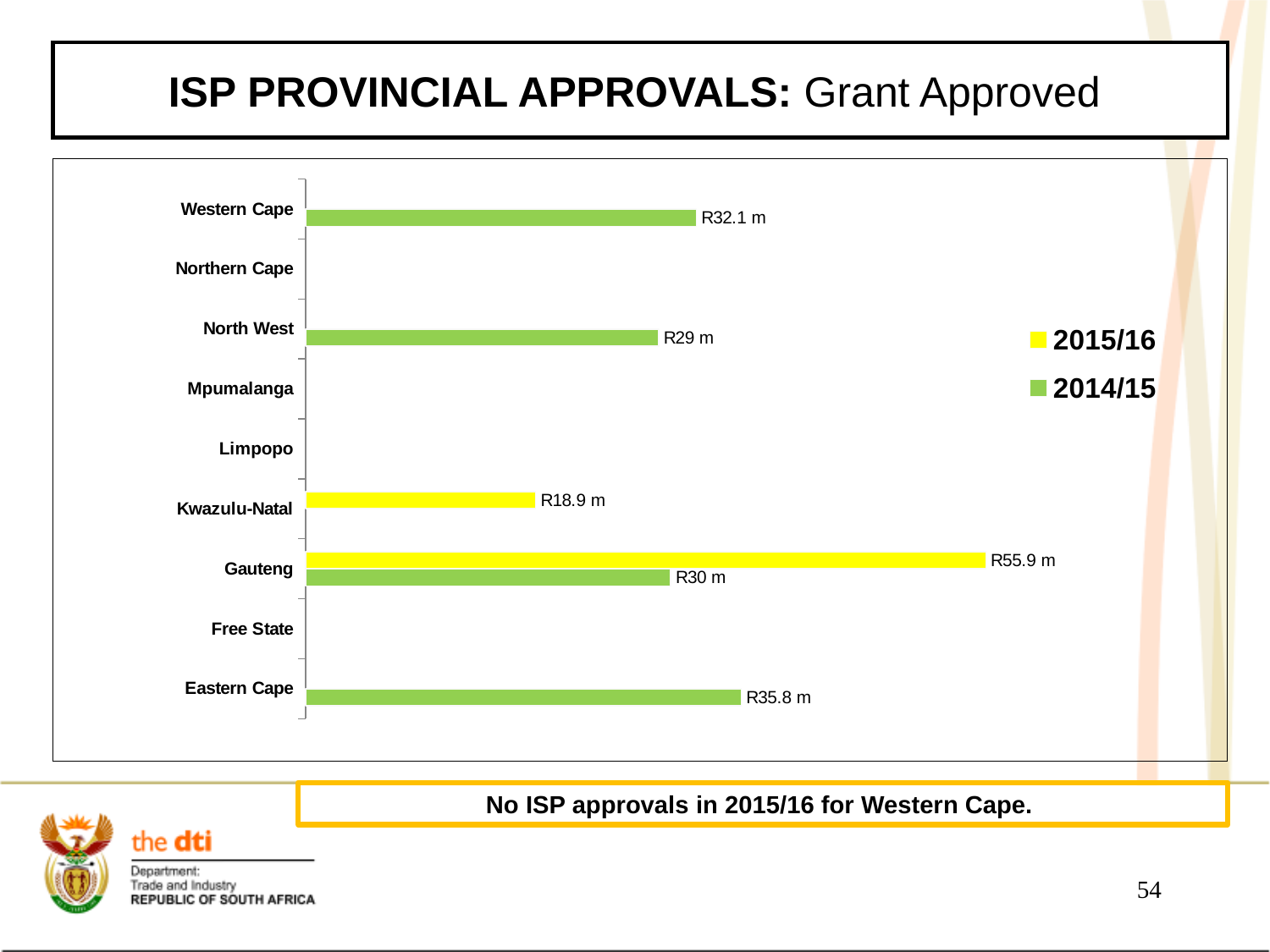
Which colour represents the 2015/16 series in the legend? Yellow How many series does the legend list? 2 Which province had the highest grant approved in 2014/15? Eastern Cape Which province had the lowest non-zero grant approved in 2014/15? North West What type of chart is shown on the slide? Bar chart What was the grant approved for Gauteng in 2015/16? R55.9 m What was the grant approved for Kwazulu-Natal in 2015/16? R18.9 m What is the difference between Gauteng's 2015/16 and 2014/15 grant approved values? R25.9 m How many provinces are listed on the vertical axis of the chart? 9 What was the grant approved for Western Cape in 2014/15? R32.1 m What was the grant approved for Eastern Cape in 2014/15? R35.8 m Which is larger: the 2014/15 grant approved for Western Cape or for North West? Western Cape